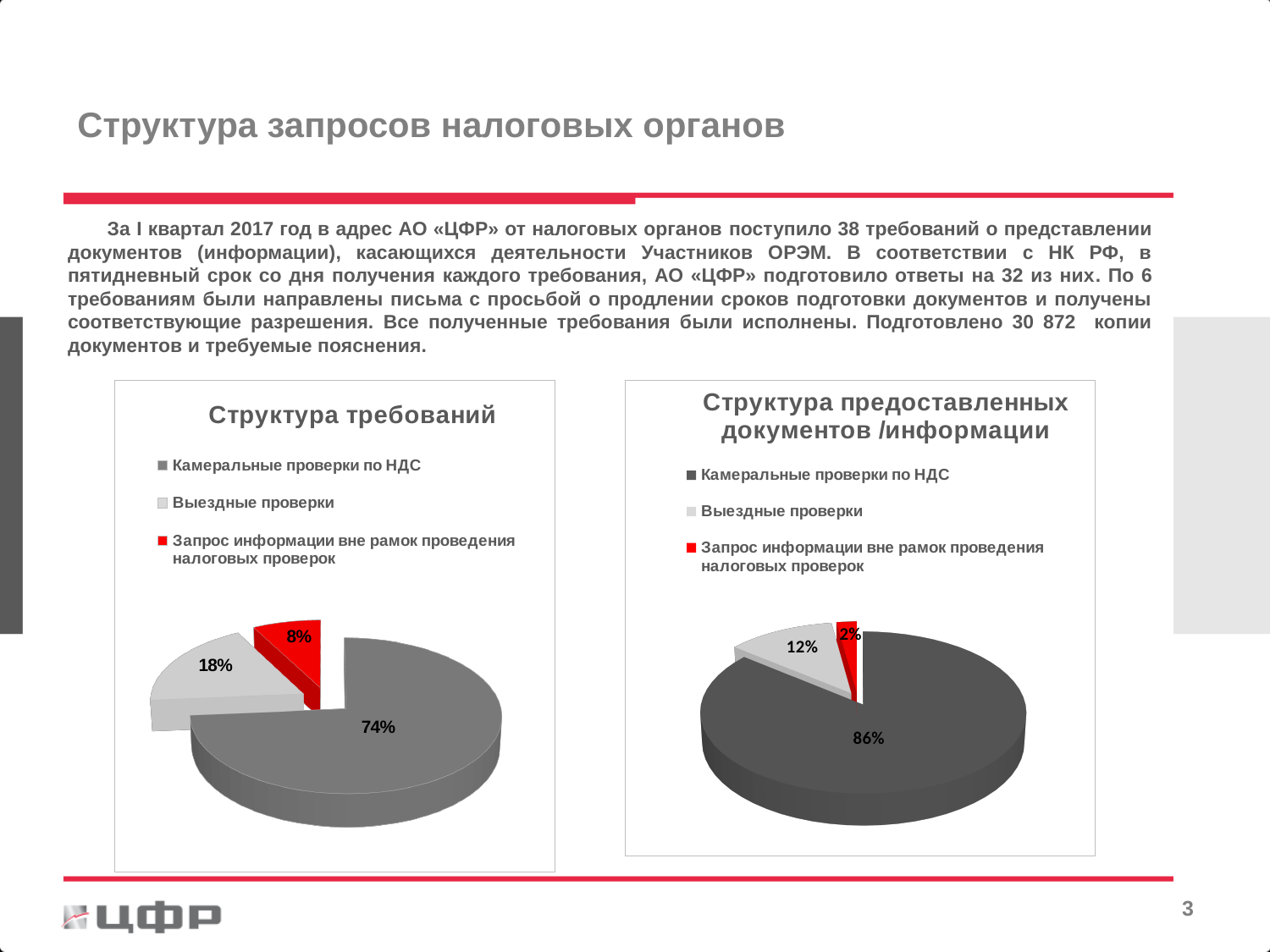
In the chart titled "Структура требований", what share does "Выездные проверки" have? 18% What type of chart is the chart titled "Структура требований"? Pie chart In the chart titled "Структура требований", which category has the largest slice? Камеральные проверки по НДС In the chart titled "Структура требований", what share does "Запрос информации вне рамок проведения налоговых проверок" have? 8% In the chart titled "Структура предоставленных документов /информации", which category has the smallest slice? Запрос информации вне рамок проведения налоговых проверок In the chart titled "Структура требований", what share does "Камеральные проверки по НДС" have? 74% In the chart titled "Структура требований", what is the difference in percentage points between "Выездные проверки" and "Запрос информации вне рамок проведения налоговых проверок"? 10 percentage points How many categories does the chart titled "Структура предоставленных документов /информации" show? 3 Which is larger: the share of "Выездные проверки" in the chart "Структура требований" or in the chart "Структура предоставленных документов /информации"? Структура требований